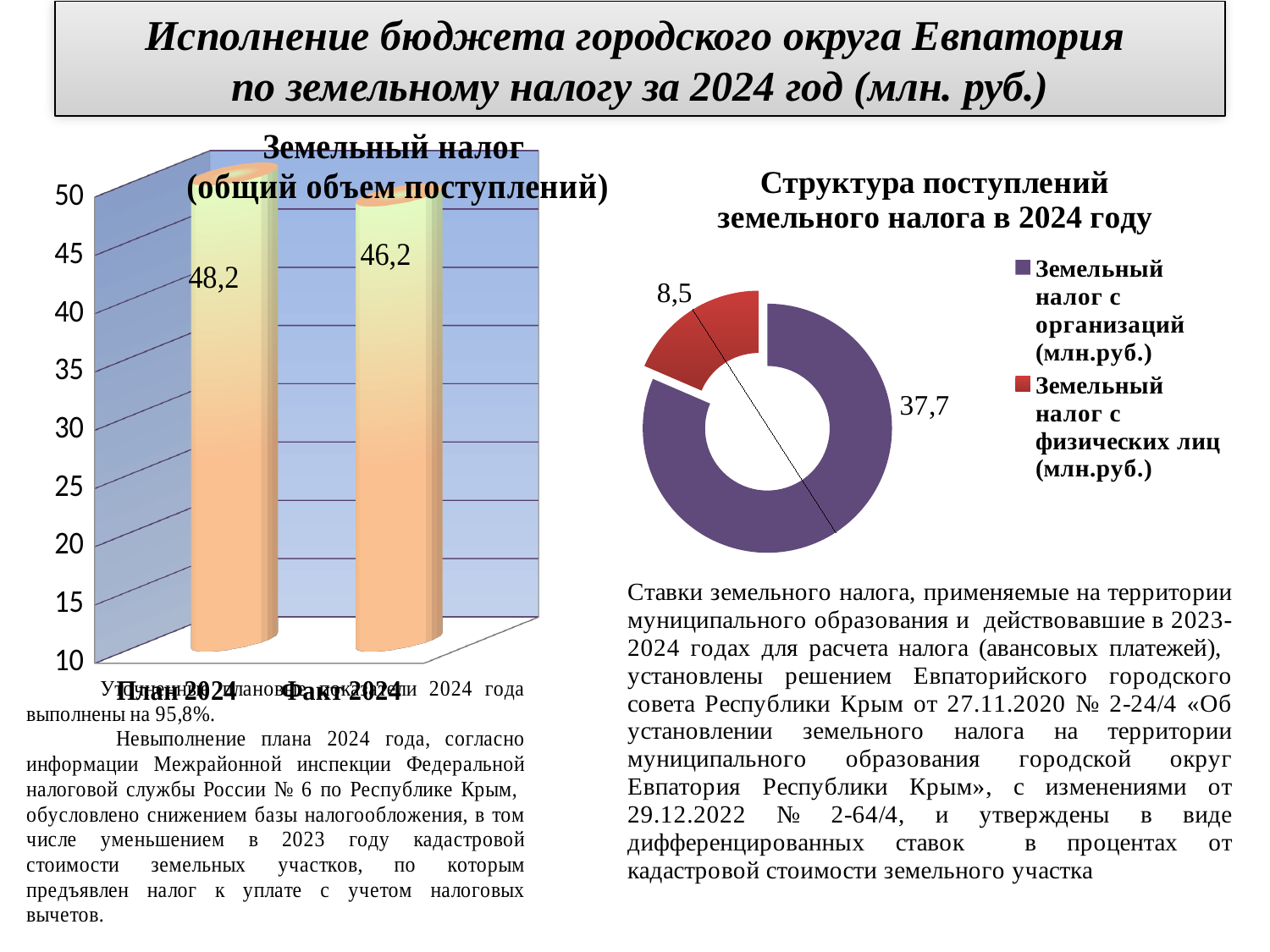
In the chart 'Структура поступлений земельного налога в 2024 году', what colour is the segment for Земельный налог с физических лиц (млн.руб.)? red In the chart 'Земельный налог (общий объем поступлений)', what is the difference between План 2024 and Факт 2024? 2,0 In the chart 'Земельный налог (общий объем поступлений)', what is the value for Факт 2024? 46,2 In the chart 'Земельный налог (общий объем поступлений)', which category has the higher value? План 2024 In the chart 'Земельный налог (общий объем поступлений)', how many bars are plotted? 2 In the chart 'Структура поступлений земельного налога в 2024 году', what is the value for Земельный налог с физических лиц (млн.руб.)? 8,5 In the chart 'Земельный налог (общий объем поступлений)', what is the value for План 2024? 48,2 In the chart 'Структура поступлений земельного налога в 2024 году', which segment is the smallest? Земельный налог с физических лиц (млн.руб.) What kind of chart is 'Земельный налог (общий объем поступлений)'? bar chart In the chart 'Структура поступлений земельного налога в 2024 году', what is the value for Земельный налог с организаций (млн.руб.)? 37,7 In the chart 'Земельный налог (общий объем поступлений)', is the value for Факт 2024 greater or less than 45? greater How many entries does the legend of the chart 'Структура поступлений земельного налога в 2024 году' list? 2